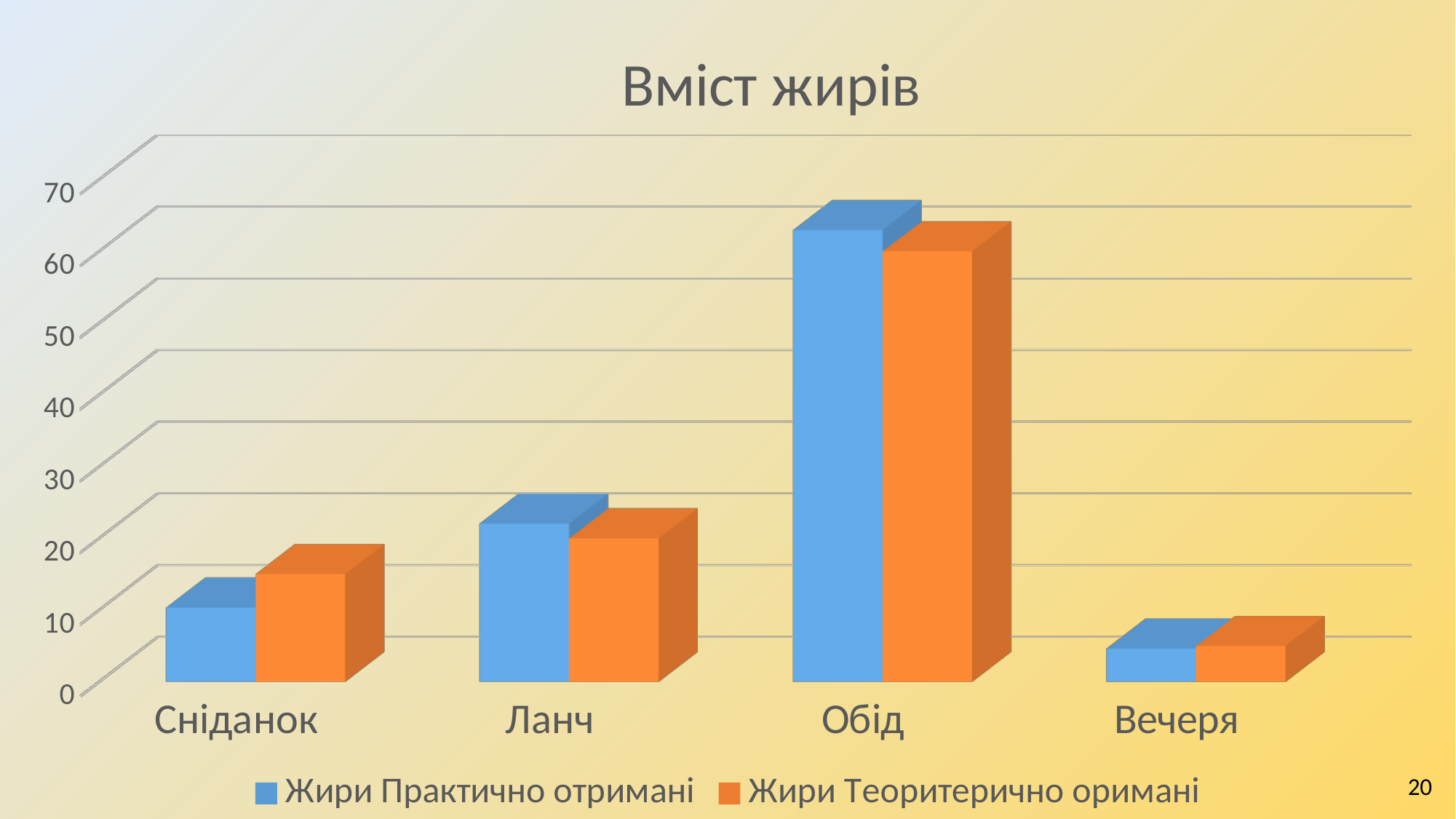
What is the title of the chart? Вміст жирів Is the value for Обід in the series "Жири Практично отримані" greater or less than 50? greater How many categories are shown on the x axis of the chart? 4 Is the value for Сніданок in the series "Жири Теоритерично оримані" greater or less than 20? less For Сніданок, which series has the larger value: "Жири Практично отримані" or "Жири Теоритерично оримані"? Жири Теоритерично оримані Which category has the lowest value for "Жири Теоритерично оримані"? Вечеря Which colour represents the series "Жири Практично отримані"? blue Which category has the highest value for "Жири Практично отримані"? Обід In the series "Жири Практично отримані", which is larger: Ланч or Обід? Обід How many series does the legend list? 2 Is the value for Вечеря in the series "Жири Практично отримані" greater or less than 10? less What kind of chart is shown on the slide? bar chart